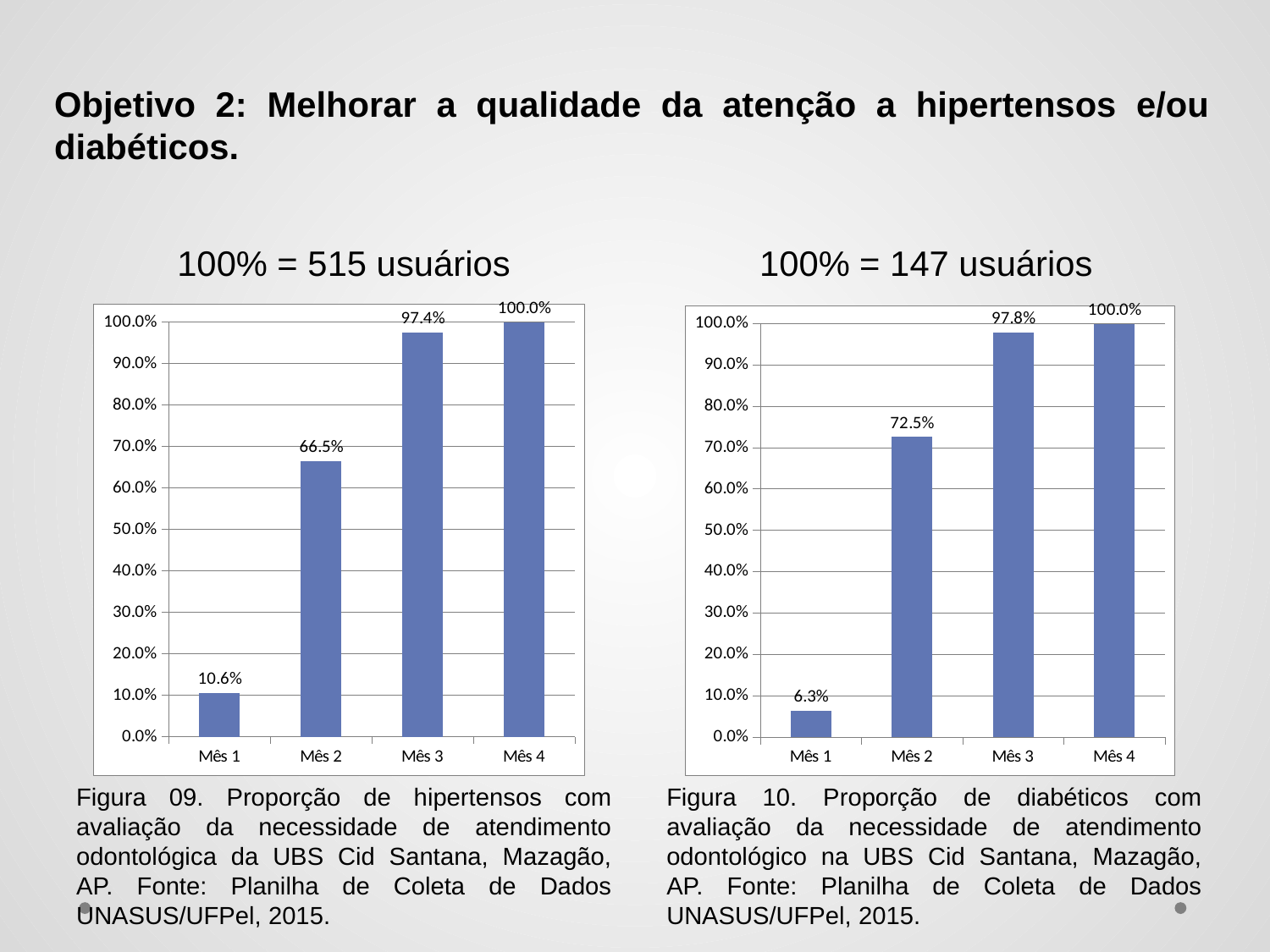
In the left chart (Figura 09, hipertensos), which month has the lowest value? Mês 1 In the left chart (Figura 09, hipertensos), what is the value for Mês 2? 66.5% What type of chart is the left chart (Figura 09, hipertensos)? Bar chart In the right chart (Figura 10, diabéticos), which month has the highest value? Mês 4 In the right chart (Figura 10, diabéticos), what is the difference between the values for Mês 3 and Mês 2? 25.3% How many months (categories) are shown in the right chart (Figura 10, diabéticos)? 4 In the right chart (Figura 10, diabéticos), do the values rise or fall from Mês 1 to Mês 4? Rise In the left chart (Figura 09, hipertensos), is the value for Mês 3 greater or less than 90.0%? greater Which is larger: the Mês 2 value in the left chart (hipertensos) or the Mês 2 value in the right chart (diabéticos)? Right chart (diabéticos), 72.5% In the right chart (Figura 10, diabéticos), what is the value for Mês 1? 6.3% In the left chart (Figura 09, hipertensos), what is the difference between the values for Mês 2 and Mês 1? 55.9% In the right chart (Figura 10, diabéticos), what is the value for Mês 3? 97.8%